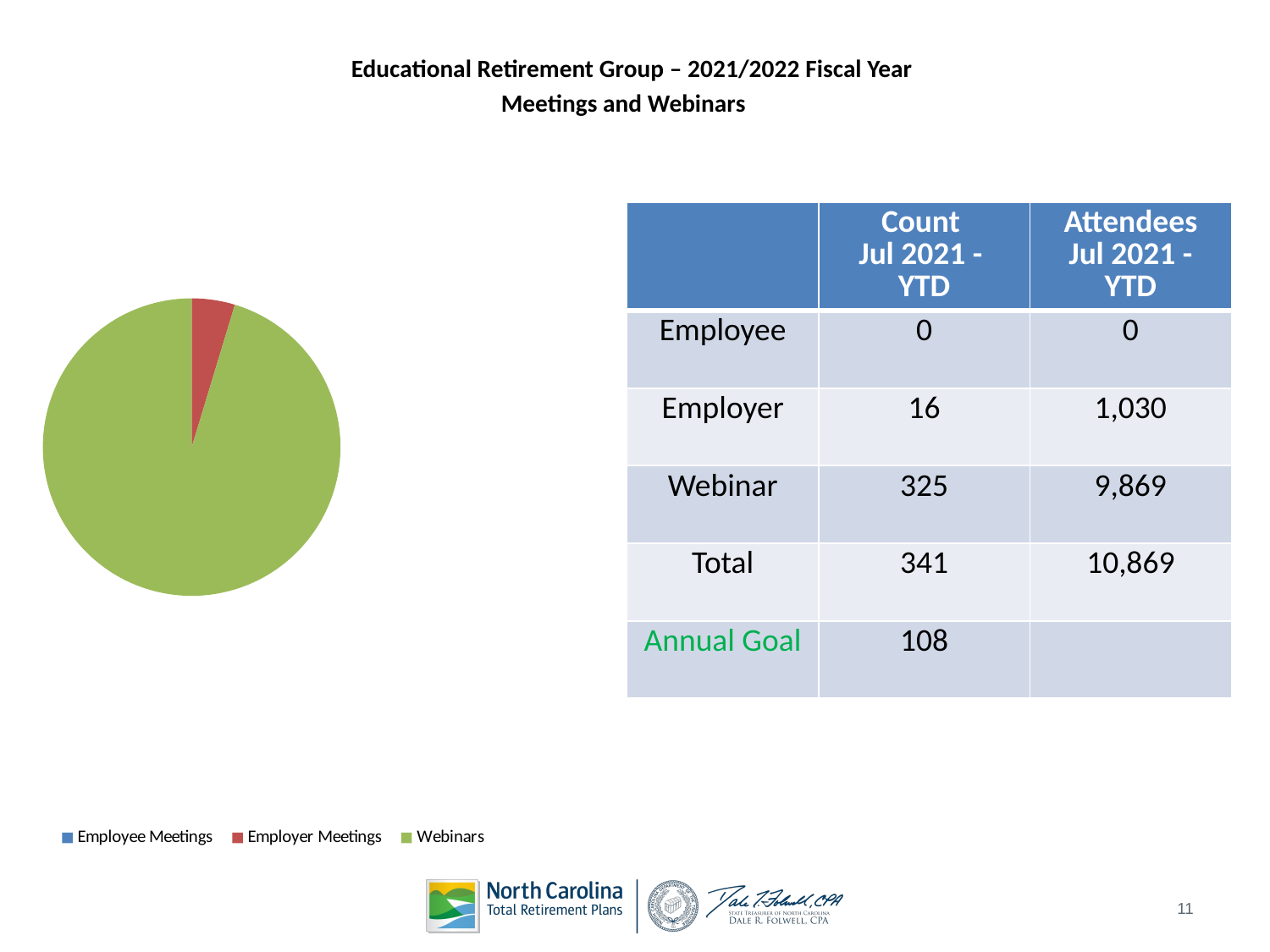
Which category has the largest slice of the pie chart? Webinars Which is larger in the pie chart, Webinars or Employer Meetings? Webinars How many categories does the pie chart's legend list? 3 What colour represents Employer Meetings in the pie chart? red What colour represents Webinars in the pie chart? green Which legend category has no visible slice in the pie chart? Employee Meetings What kind of chart is shown on the slide? pie chart